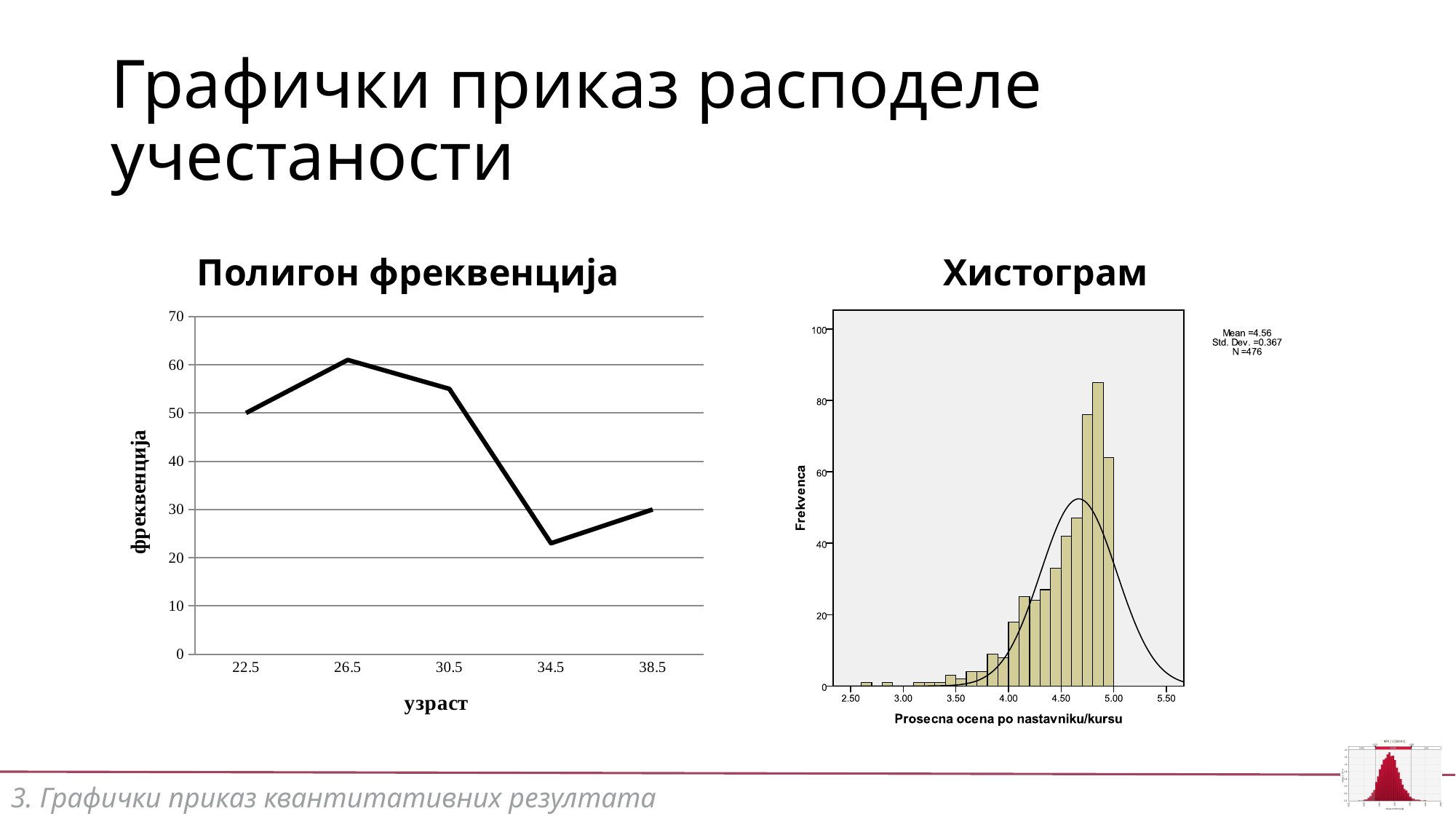
In the 'Полигон фреквенција' chart, which has a higher frequency, age 30.5 or age 34.5? 30.5 In the 'Полигон фреквенција' chart, which age category has the lowest frequency? 34.5 In the 'Хистограм' chart, is the tallest bar greater or less than 80? greater In the 'Полигон фреквенција' chart, which age category has the highest frequency? 26.5 In the 'Полигон фреквенција' chart, is the frequency for age 34.5 greater or less than 30? less In the 'Полигон фреквенција' chart, what is the frequency for age 38.5? 30 What kind of chart is the 'Полигон фреквенција' chart on the left? line chart In the 'Полигон фреквенција' chart, what is the frequency for age 22.5? 50 In the 'Полигон фреквенција' chart, does the frequency rise or fall between age 30.5 and age 34.5? fall In the 'Полигон фреквенција' chart, how many age categories are shown on the x axis? 5 In the 'Хистограм' chart, what is the value of N shown in the statistics box? 476